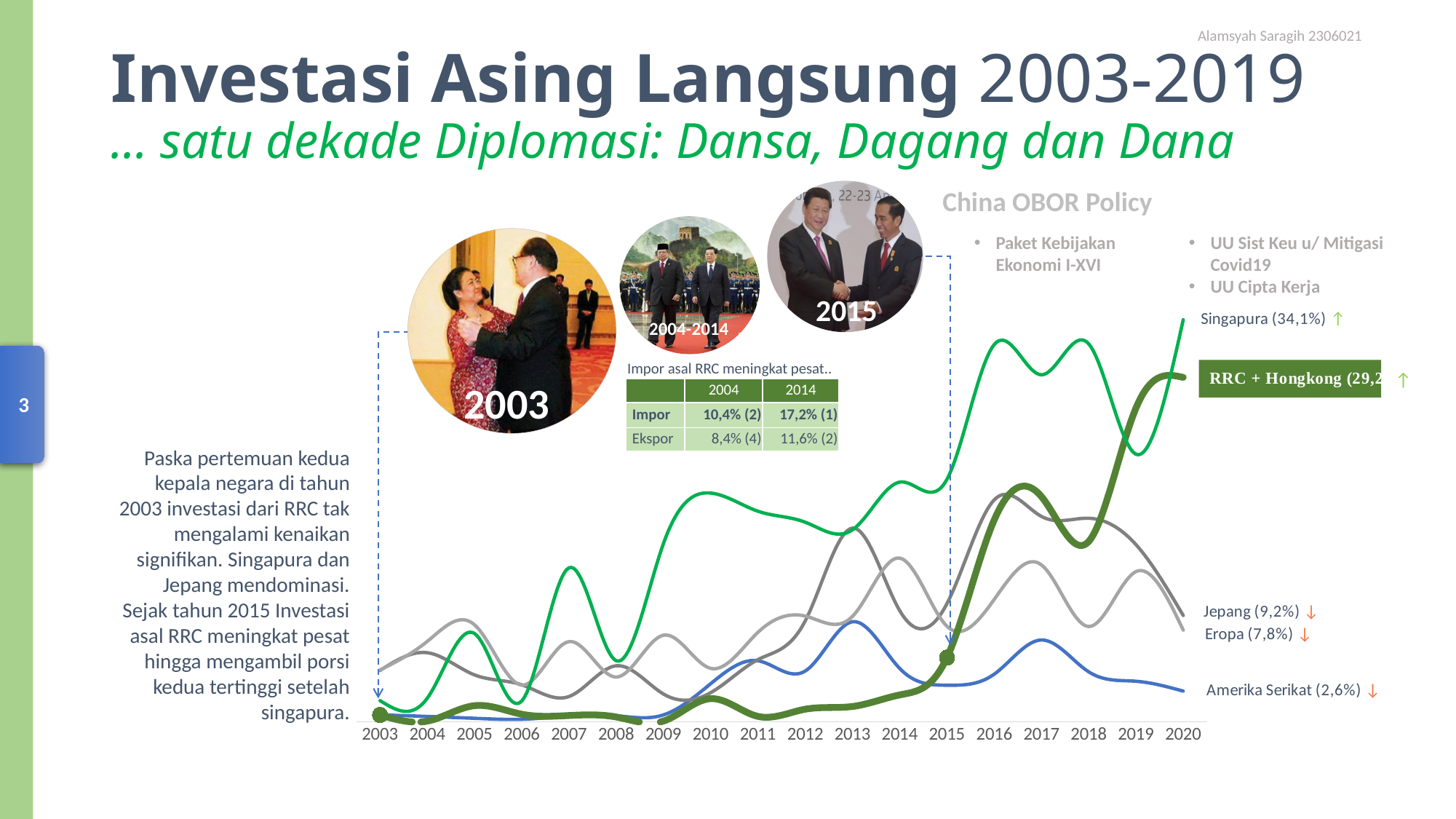
What is the difference between the printed shares for Singapura (34,1%) and Jepang (9,2%)? 24,9% Which series has the highest value at the end of the chart (2020)? Singapura What share is printed next to the Singapura line at the end of the chart? 34,1% How many series are labelled on the chart? 5 What share is printed next to the Amerika Serikat line at the end of the chart? 2,6% How many years are labelled on the x axis of the chart? 18 Does the RRC + Hongkong line rise or fall between 2015 and 2020? rise Which series has the lowest value at the end of the chart (2020)? Amerika Serikat What is the last year shown on the x axis of the chart? 2020 What share is printed next to the Jepang line at the end of the chart? 9,2% What kind of chart is shown on the slide? line chart What is the first year shown on the x axis of the chart? 2003